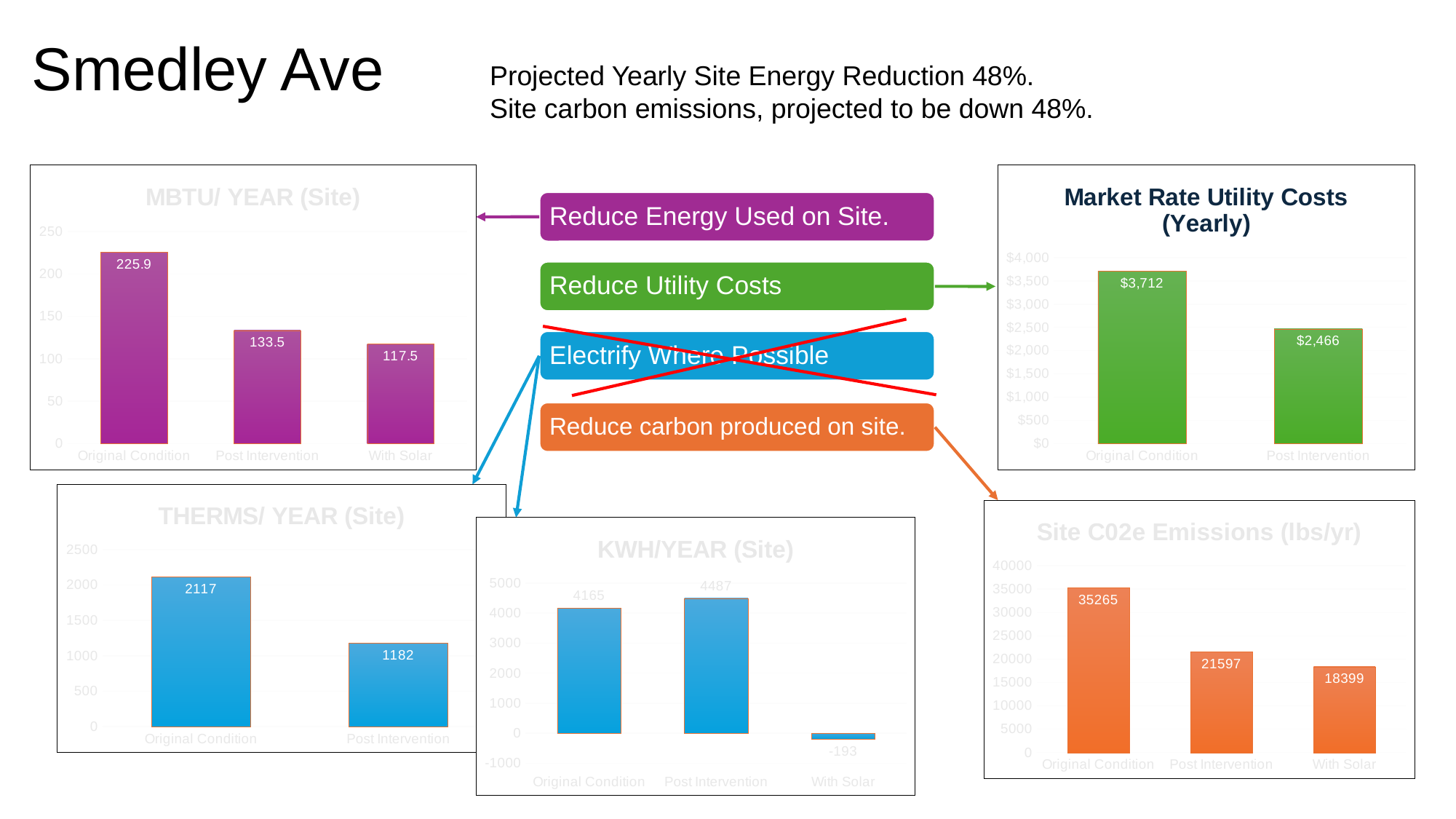
In the MBTU/ YEAR (Site) chart, what is the difference between Original Condition and Post Intervention? 92.4 What type of chart is the Site C02e Emissions (lbs/yr) chart? Bar chart In the THERMS/ YEAR (Site) chart, how many categories are shown? 2 In the Market Rate Utility Costs (Yearly) chart, what is the value for Post Intervention? $2,466 In the THERMS/ YEAR (Site) chart, what is the value for Post Intervention? 1182 In the Site C02e Emissions (lbs/yr) chart, which category has the lowest value? With Solar In the KWH/YEAR (Site) chart, what is the value for With Solar? -193 In the MBTU/ YEAR (Site) chart, what is the value for With Solar? 117.5 In the Market Rate Utility Costs (Yearly) chart, which category has the highest value? Original Condition In the MBTU/ YEAR (Site) chart, what is the value for Original Condition? 225.9 In the Site C02e Emissions (lbs/yr) chart, what is the value for Post Intervention? 21597 In the KWH/YEAR (Site) chart, which is larger, Original Condition or Post Intervention? Post Intervention